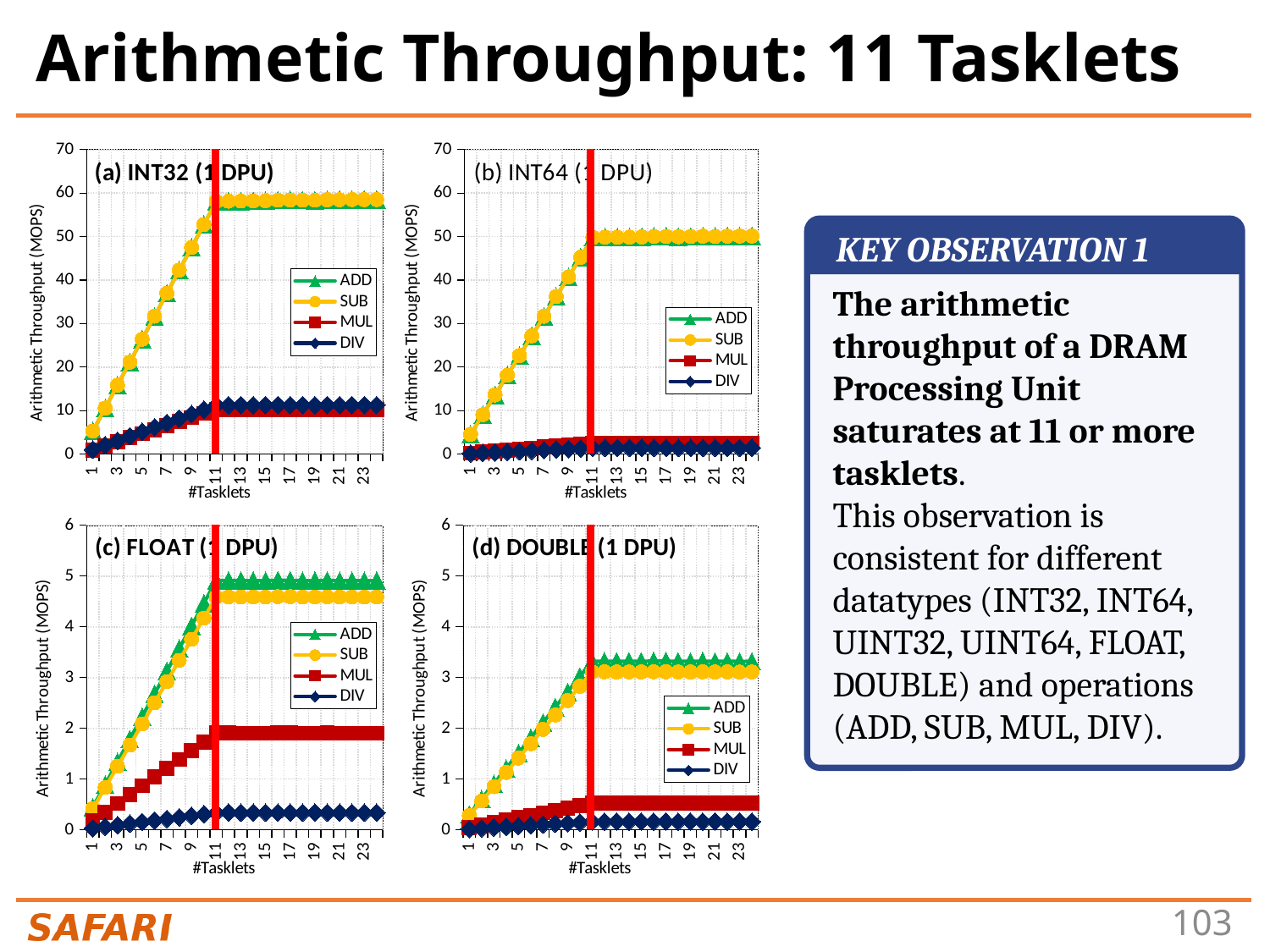
In the chart titled "(a) INT32 (1 DPU)", is the DIV value at 23 tasklets greater or less than 20? less What kind of chart is the chart titled "(a) INT32 (1 DPU)"? line chart What is the y-axis label of the chart titled "(b) INT64 (1 DPU)"? Arithmetic Throughput (MOPS) In the chart titled "(c) FLOAT (1 DPU)", which is larger at 23 tasklets, MUL or DIV? MUL In the chart titled "(c) FLOAT (1 DPU)", is the ADD value at 23 tasklets greater or less than 4? greater In the chart titled "(b) INT64 (1 DPU)", is the SUB value at 23 tasklets greater or less than 40? greater In the chart titled "(a) INT32 (1 DPU)", how many series does the legend list? 4 In the chart titled "(a) INT32 (1 DPU)", does the ADD series rise or fall as the number of tasklets increases from 1 to 11? rise In the chart titled "(c) FLOAT (1 DPU)", which series are listed in the legend? ADD, SUB, MUL, DIV